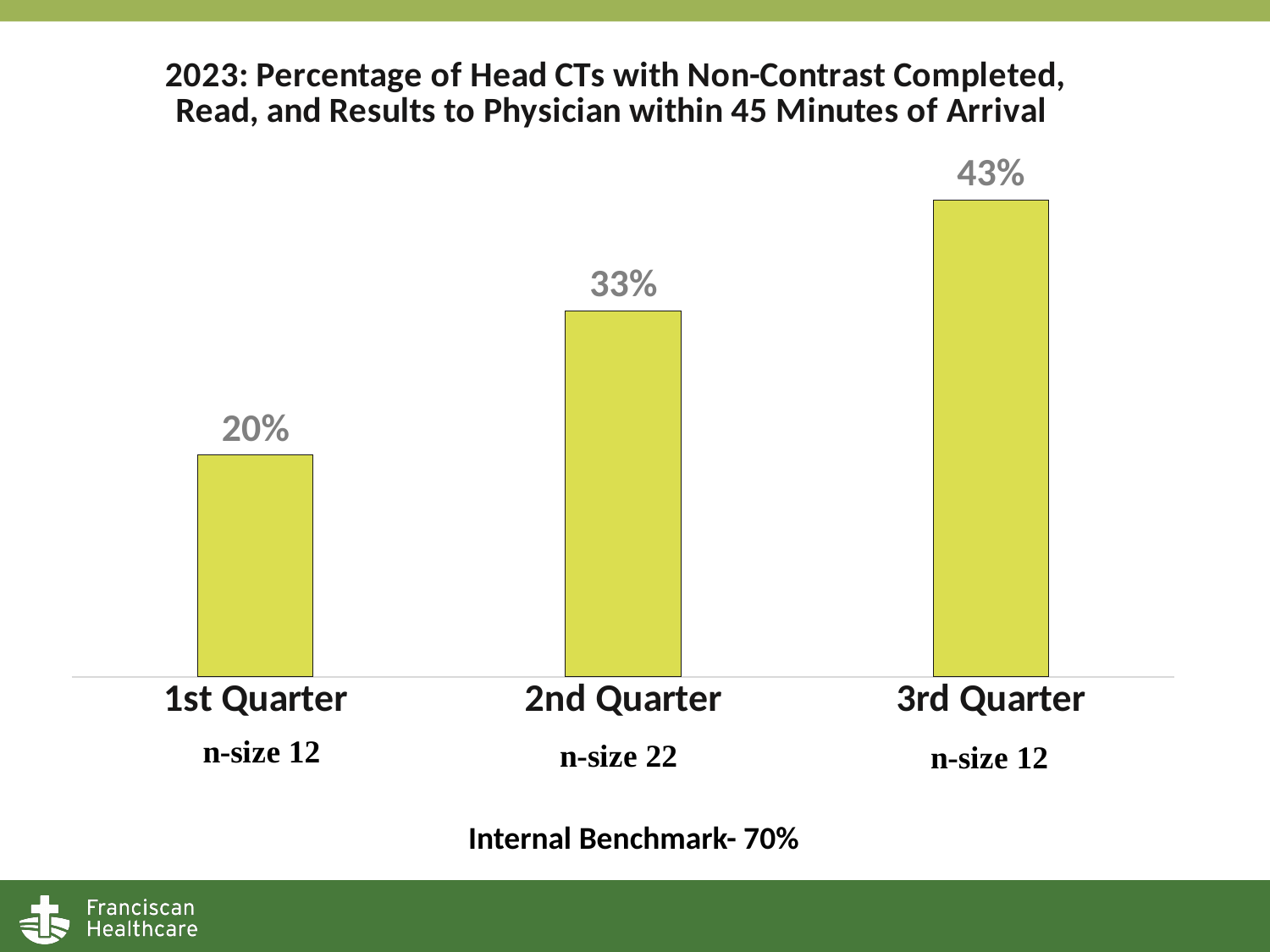
Do the values rise or fall from 1st Quarter to 3rd Quarter? Rise What is the difference between the 3rd Quarter and 1st Quarter values? 23% What kind of chart is shown on the slide? Bar chart What is the difference between the 2nd Quarter and 1st Quarter values? 13% What is the internal benchmark stated on the slide? 70% Which quarter has the lowest percentage? 1st Quarter How many quarters are shown in the chart? 3 Which is larger, the value for 2nd Quarter or 3rd Quarter? 3rd Quarter What is the value for 1st Quarter? 20% What is the value for 3rd Quarter? 43% Which quarter has the highest percentage? 3rd Quarter What is the value for 2nd Quarter? 33%